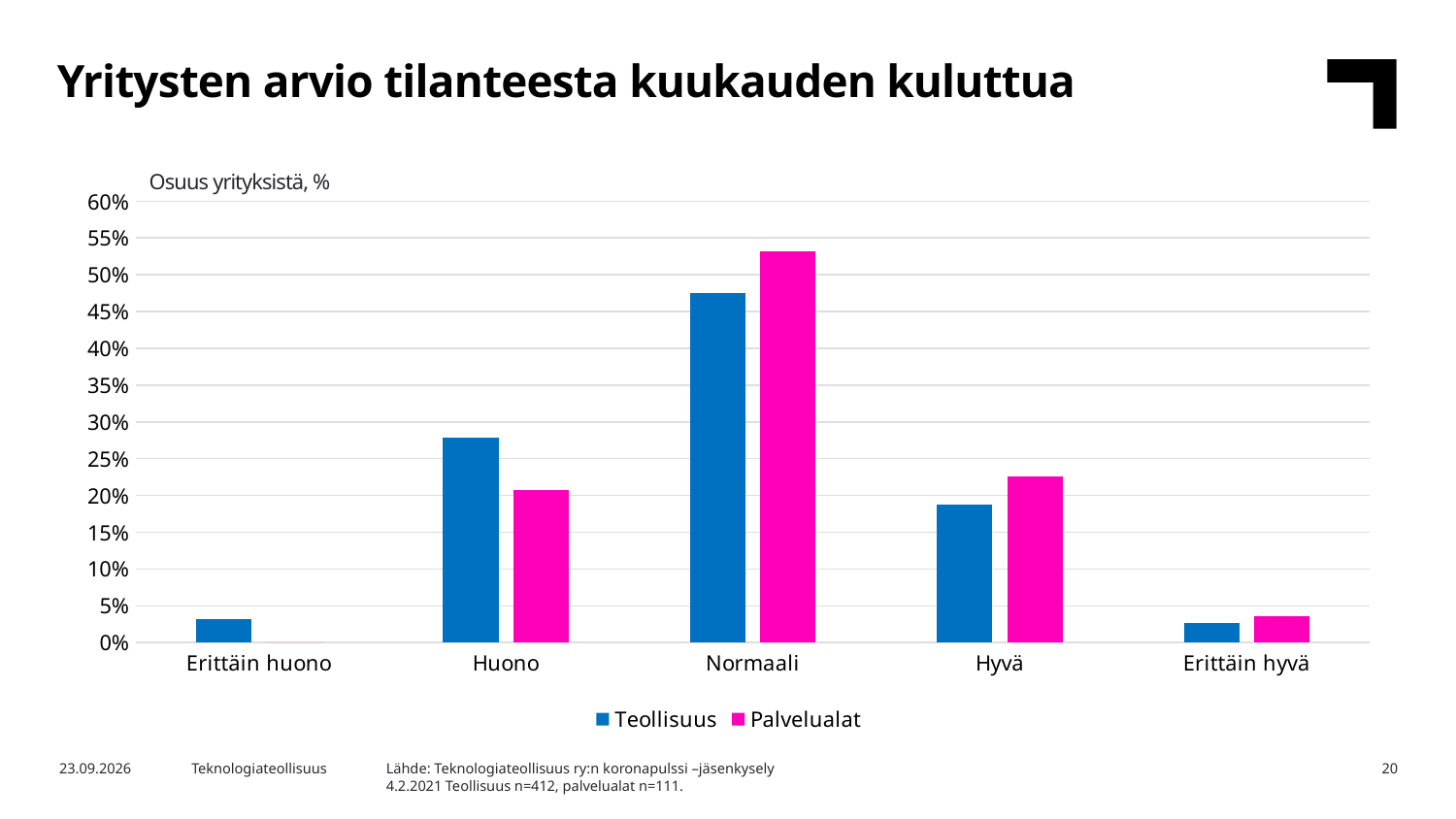
Is the Palvelualat value for Normaali greater or less than 50%? greater How many categories are shown on the x axis? 5 Which category has the highest value for Palvelualat? Normaali What kind of chart is shown on the slide? bar chart How many series does the legend list? 2 Is the Teollisuus value for Normaali greater or less than 50%? less Which category has the lowest value for Palvelualat? Erittäin huono Is the Teollisuus value for Huono greater or less than 25%? greater Which category has the highest value for Teollisuus? Normaali What is the title of the chart? Yritysten arvio tilanteesta kuukauden kuluttua For the Huono category, which series has the larger value, Teollisuus or Palvelualat? Teollisuus